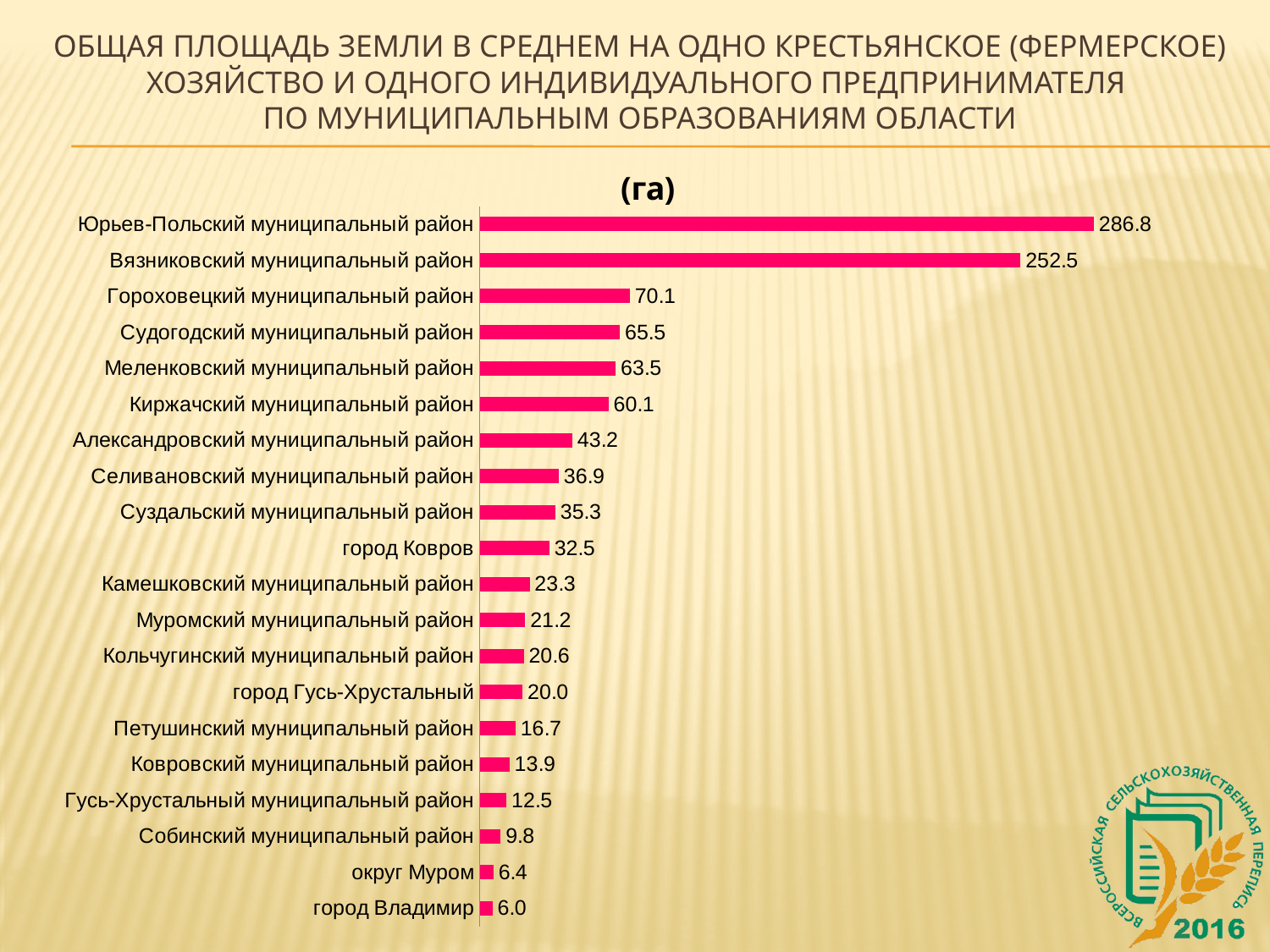
Which is larger, the value for округ Муром or the value for Петушинский муниципальный район? Петушинский муниципальный район What is the difference between the values for Гороховецкий муниципальный район and Судогодский муниципальный район? 4.6 Which is larger, the value for Александровский муниципальный район or the value for Селивановский муниципальный район? Александровский муниципальный район Which category has the lowest value? город Владимир What kind of chart is shown on the slide? bar chart What is the value for город Ковров? 32.5 What is the value for Собинский муниципальный район? 9.8 What is the difference between the values for Юрьев-Польский муниципальный район and Вязниковский муниципальный район? 34.3 What unit is given in the chart title? га Which category has the highest value? Юрьев-Польский муниципальный район How many categories are shown in the chart? 20 What is the value for Юрьев-Польский муниципальный район? 286.8